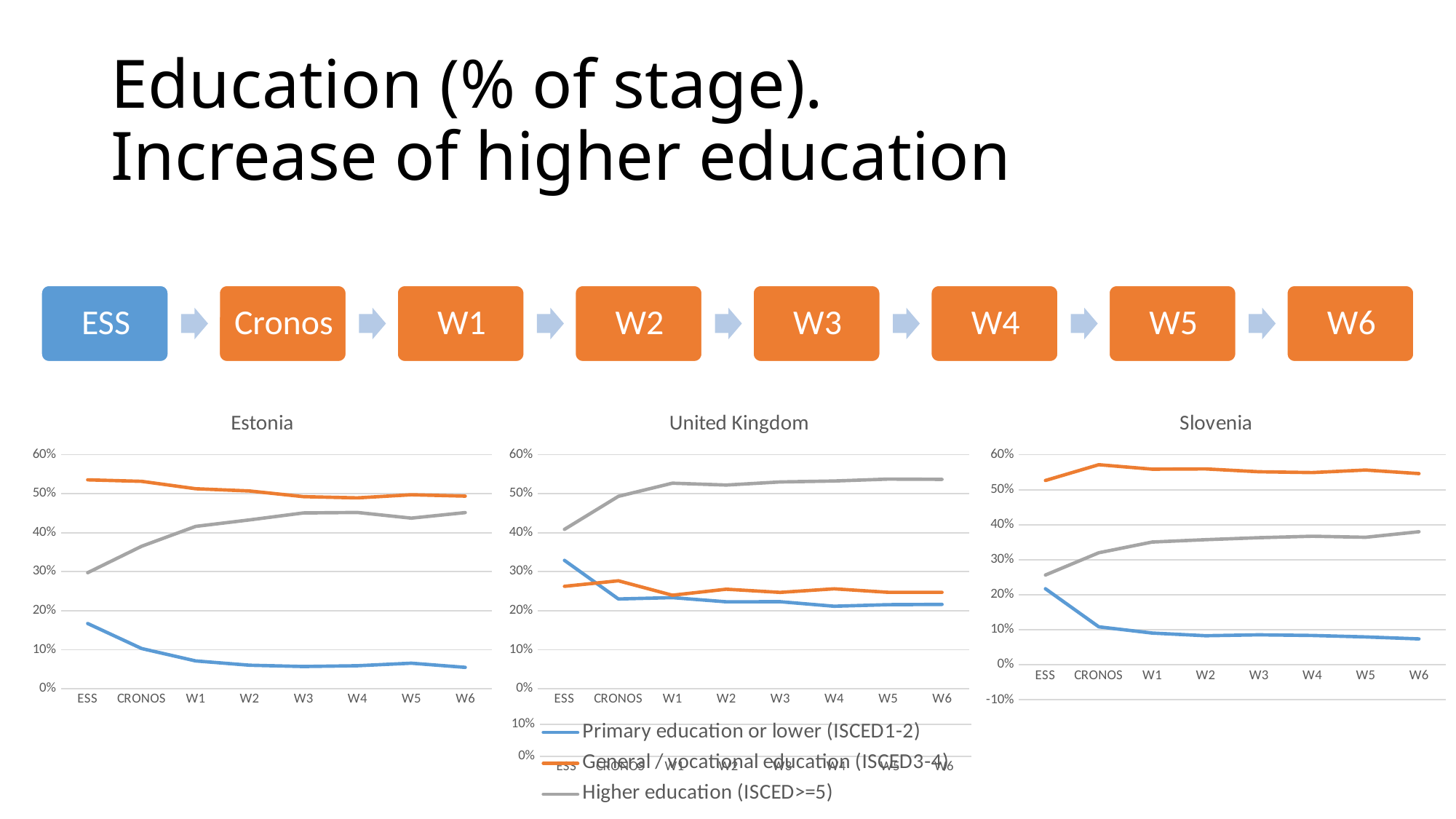
How many series does the legend list? 3 How many stages are plotted along the x axis of the Slovenia chart? 8 In the Slovenia chart, is the General / vocational education (ISCED3-4) value at CRONOS greater or less than 50%? greater What kind of chart is the Estonia chart? line chart In the Estonia chart, does the Higher education (ISCED>=5) line rise or fall from ESS to W6? rise In the United Kingdom chart, is the Higher education (ISCED>=5) value at W6 greater or less than 50%? greater In the United Kingdom chart, at ESS, which is larger: Primary education or lower (ISCED1-2) or General / vocational education (ISCED3-4)? Primary education or lower (ISCED1-2) What is the title of the chart on the right of the slide? Slovenia In the United Kingdom chart, which series has the highest value at W6? Higher education (ISCED>=5) In the Estonia chart, at which stage is the Primary education or lower (ISCED1-2) value highest? ESS In the Slovenia chart, does the Primary education or lower (ISCED1-2) line rise or fall from ESS to W6? fall In the Estonia chart, is the Primary education or lower (ISCED1-2) value at W6 greater or less than 10%? less